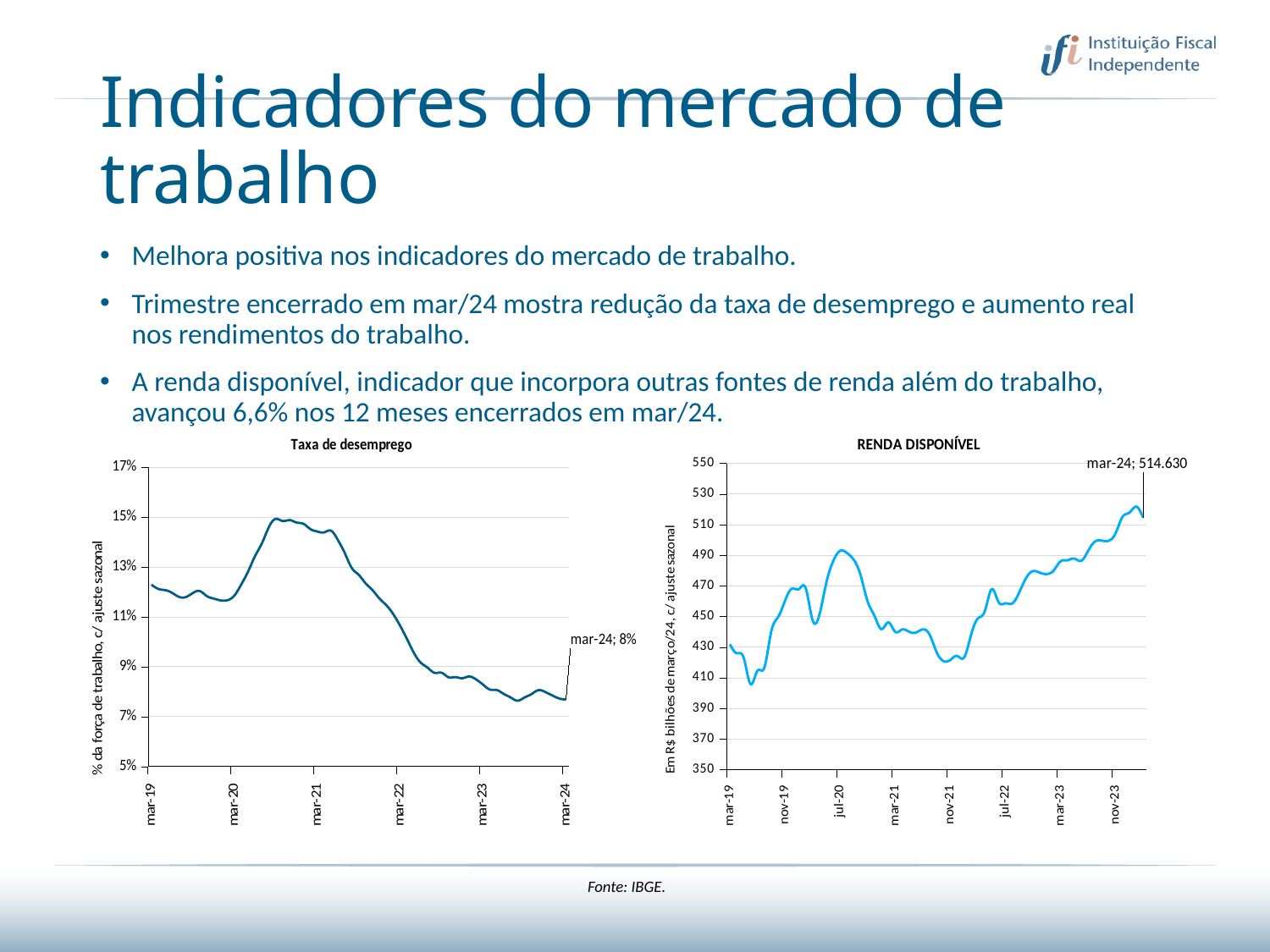
On the 'RENDA DISPONÍVEL' chart, is the peak value around jul-20 greater or less than 470? greater On the 'Taxa de desemprego' chart, does the unemployment rate overall rise or fall between mar-19 and mar-24? Fall What kind of chart is the 'Taxa de desemprego' chart? Line chart On the 'RENDA DISPONÍVEL' chart, what value is labelled for mar-24? 514.630 On the 'Taxa de desemprego' chart, what value is labelled for mar-24? 8% On the 'Taxa de desemprego' chart, is the peak value reached in 2020 greater or less than 13%? greater What is the y-axis label of the 'Taxa de desemprego' chart? % da força de trabalho, c/ ajuste sazonal On the 'Taxa de desemprego' chart, is the value at mar-19 greater or less than 11%? greater What is the y-axis label of the 'RENDA DISPONÍVEL' chart? Em R$ bilhões de março/24, c/ ajuste sazonal On the 'RENDA DISPONÍVEL' chart, does the series overall rise or fall between mar-19 and mar-24? Rise What kind of chart is the 'RENDA DISPONÍVEL' chart? Line chart